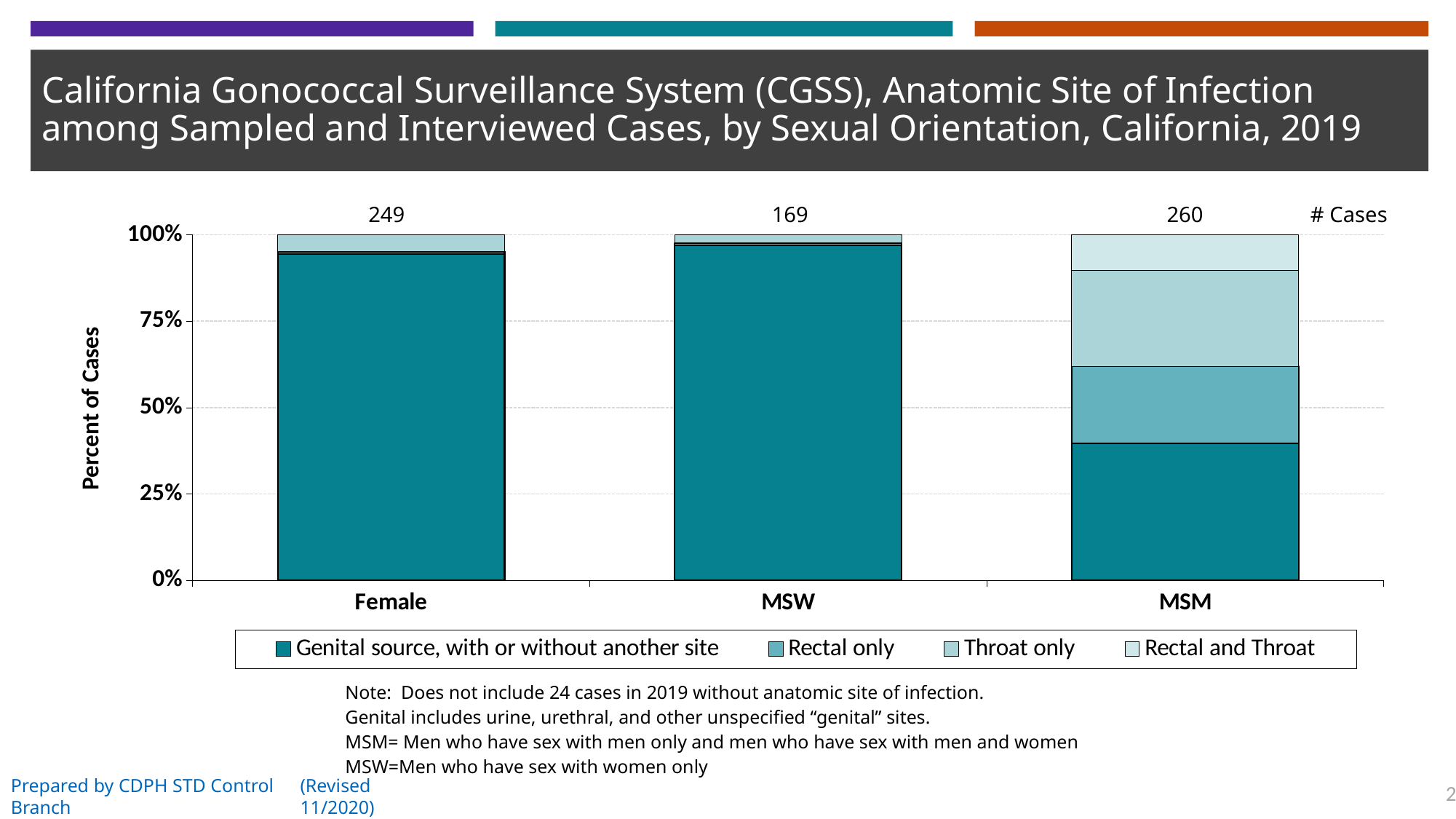
Is the share of 'Genital source, with or without another site' for Female greater or less than 75%? greater Is the share of 'Genital source, with or without another site' for MSM greater or less than 50%? less How many cases are shown above the MSM bar? 260 Which group has the smallest number of cases printed above its bar? MSW How many cases are shown above the Female bar? 249 How many series does the legend list? 4 Which group has more cases, Female or MSW? Female How many cases are shown above the MSW bar? 169 What is the difference between the number of cases for Female and for MSW? 80 How many groups are shown on the x axis? 3 Which group has the largest number of cases printed above its bar? MSM What is the difference between the number of cases for MSM and for Female? 11